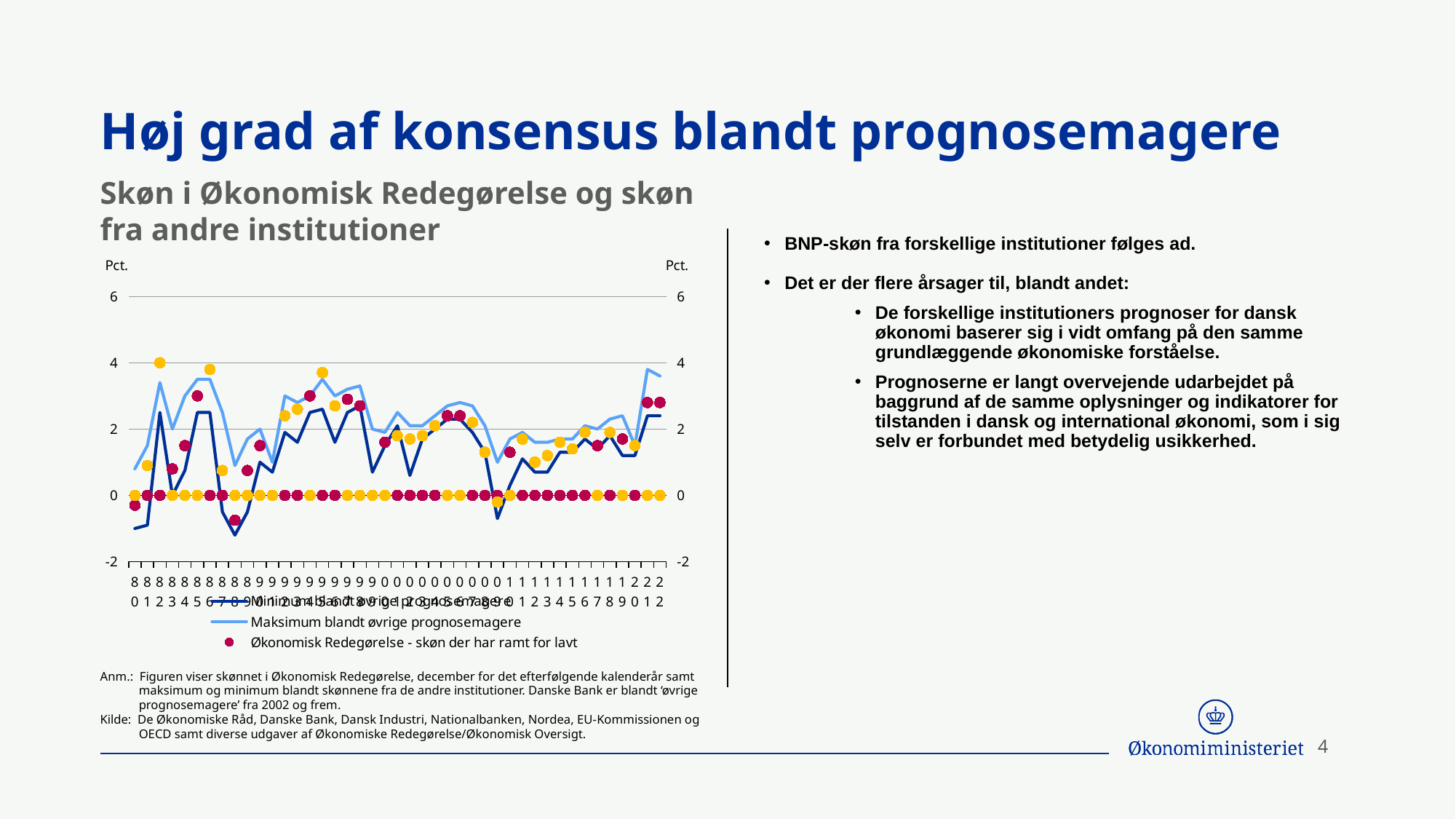
What kind of chart is shown on the slide? line chart Is the value of the 'Minimum blandt øvrige prognosemagere' line for 2009 greater or less than 0? less What is the lowest value shown on the vertical axis of the chart? -2 Is the value of the 'Minimum blandt øvrige prognosemagere' line for 1981 greater or less than 0? less Which is larger for 2021: the 'Maksimum blandt øvrige prognosemagere' line or the 'Minimum blandt øvrige prognosemagere' line? Maksimum blandt øvrige prognosemagere Which legend entry is drawn as a red dot marker? Økonomisk Redegørelse - skøn der har ramt for lavt What is the first year shown on the x axis of the chart? 80 What unit label is shown at the top of the vertical axes of the chart? Pct.